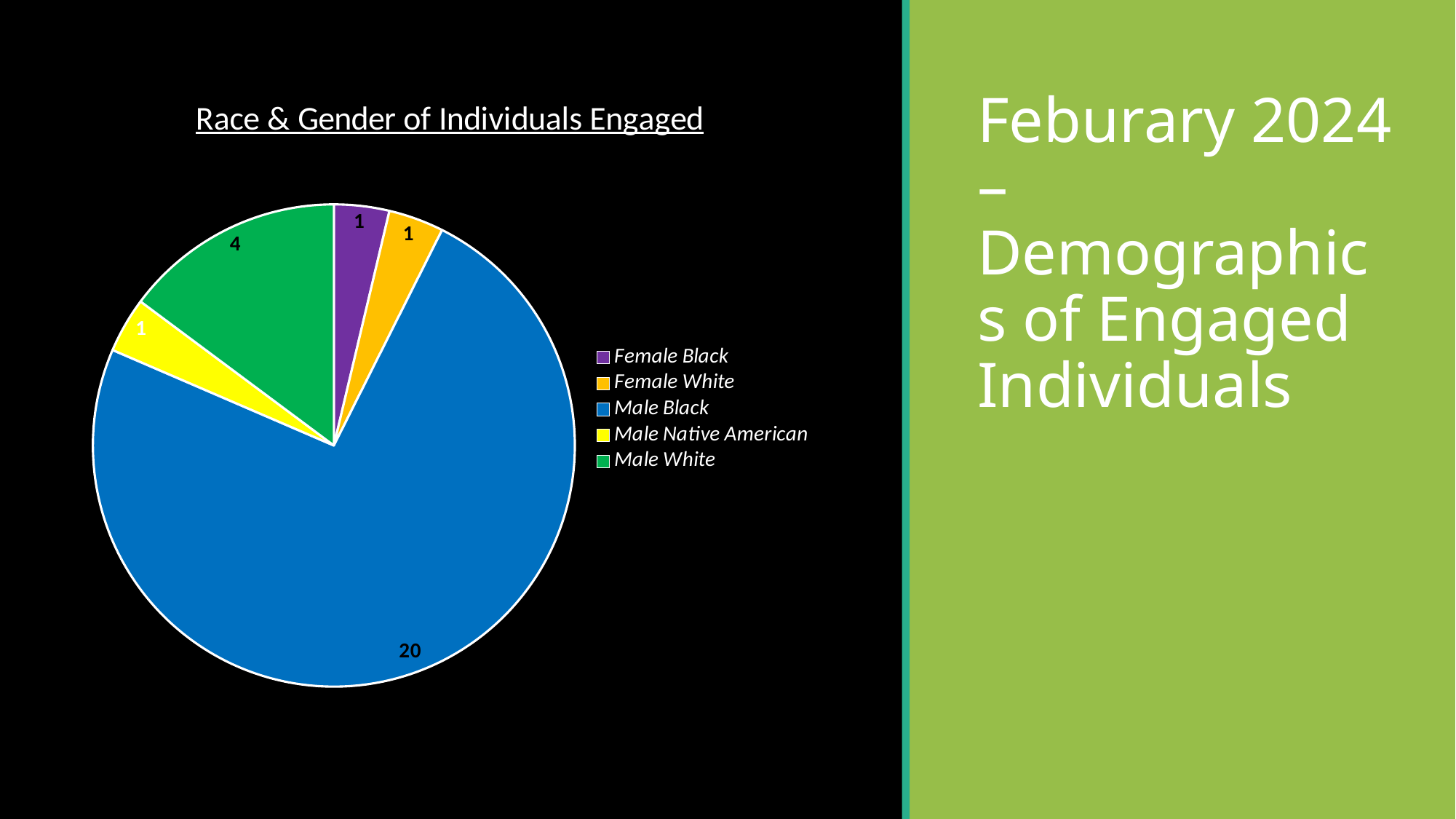
What is the value for Male White? 4 What is the value for Female Black? 1 What is the difference between the values for Male Black and Male White? 16 Which is larger, the value for Male White or the value for Female White? Male White Which colour represents Male Native American in the legend? Yellow What type of chart is shown on the slide? Pie chart What is the total of all the slices in the pie chart? 27 Which category has the largest slice of the pie? Male Black What is the title of the chart? Race & Gender of Individuals Engaged How many categories does the pie chart have? 5 What is the value for Male Black? 20 What is the value for Male Native American? 1